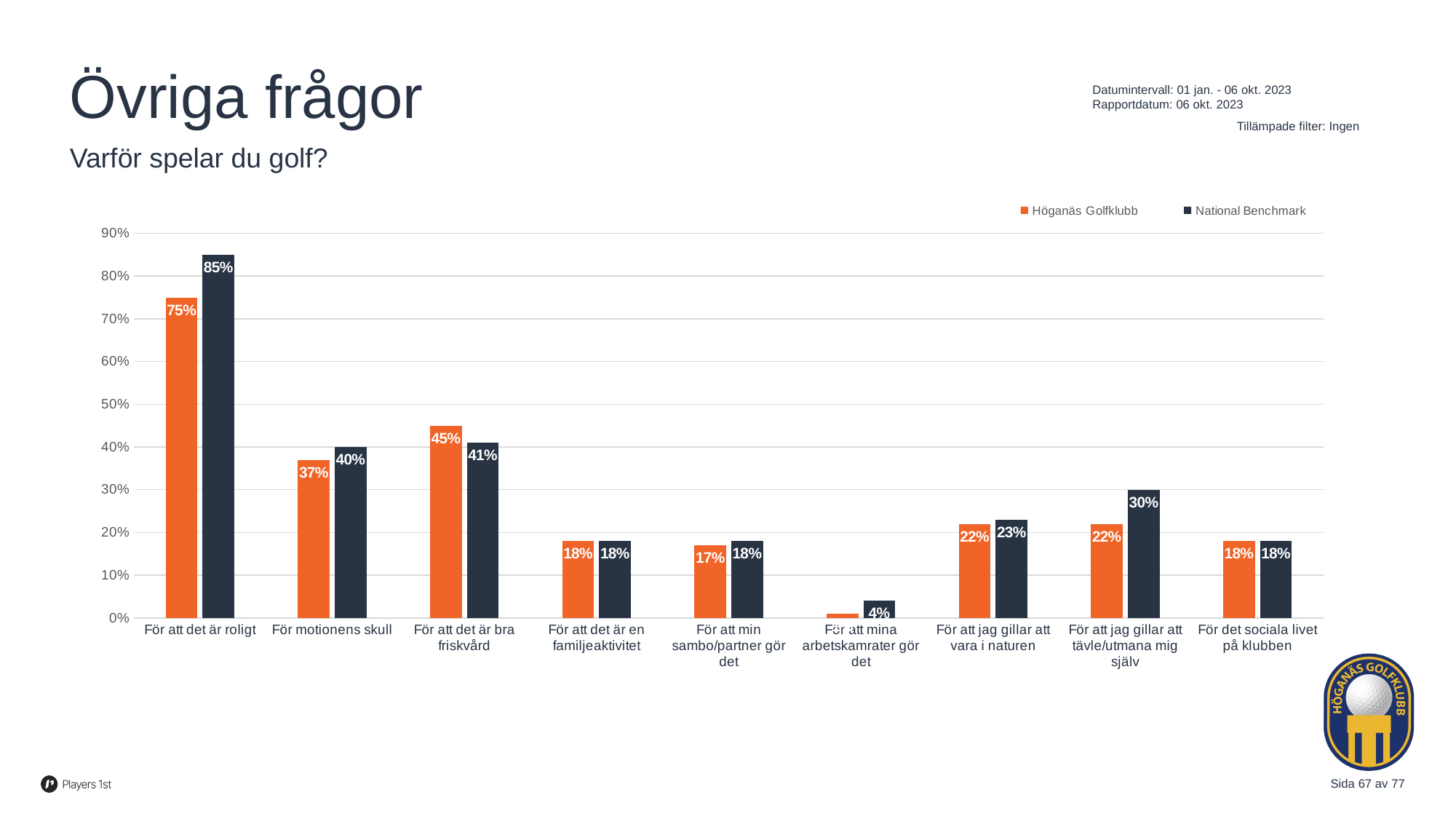
What is the value for Höganäs Golfklubb for "För att det är roligt"? 75% What is the Höganäs Golfklubb value for "För att det är bra friskvård"? 45% Which colour represents National Benchmark in the chart? dark navy What is the difference between the National Benchmark and Höganäs Golfklubb values for "För att det är roligt"? 10% What kind of chart is shown on the slide? bar chart How many series does the legend list? 2 For "För att det är bra friskvård", which is larger: Höganäs Golfklubb or National Benchmark? Höganäs Golfklubb What is the National Benchmark value for "För att jag gillar att tävle/utmana mig själv"? 30% Which category has the lowest Höganäs Golfklubb value? För att mina arbetskamrater gör det Is the Höganäs Golfklubb value for "För att mina arbetskamrater gör det" greater or less than 10%? less Which category has the highest National Benchmark value? För att det är roligt How many categories are shown on the x axis? 9